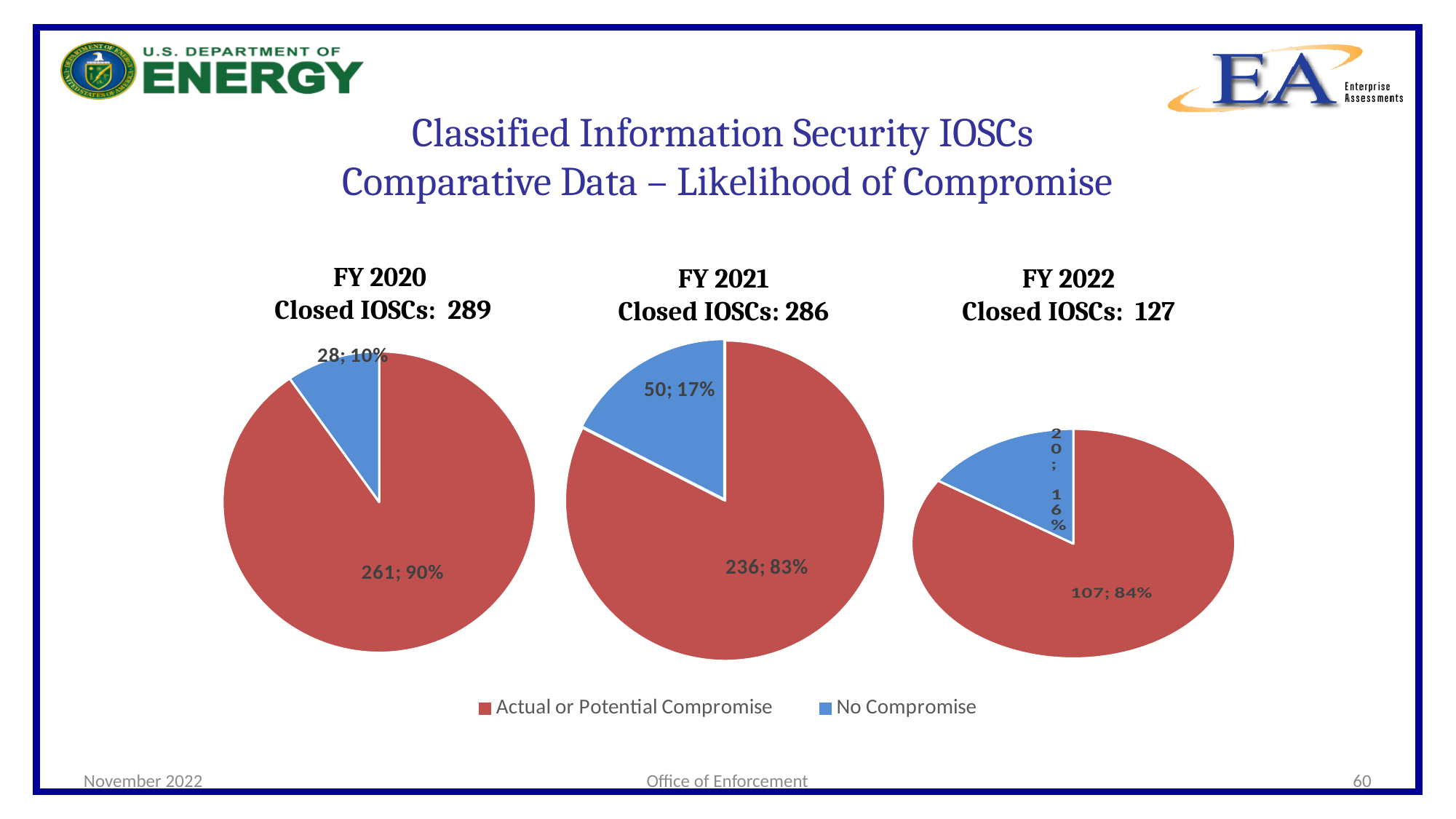
In the FY 2022 pie chart, how many closed IOSCs were No Compromise? 20 In the FY 2020 pie chart, what is the difference between the Actual or Potential Compromise count and the No Compromise count? 233 What type of chart is used for the FY 2020 data? Pie chart What is the total number of closed IOSCs shown for FY 2021? 286 How many pie charts are shown on the slide? 3 Which fiscal year's chart has the smallest number of closed IOSCs? FY 2022 In the FY 2020 pie chart, how many closed IOSCs were Actual or Potential Compromise? 261 In the FY 2022 pie chart, what share of closed IOSCs was Actual or Potential Compromise? 84% In the FY 2021 pie chart, what share of closed IOSCs was No Compromise? 17% In the FY 2021 pie chart, which slice is larger, Actual or Potential Compromise or No Compromise? Actual or Potential Compromise In the FY 2020 pie chart, what share of closed IOSCs was No Compromise? 10% How many series does the legend list? 2